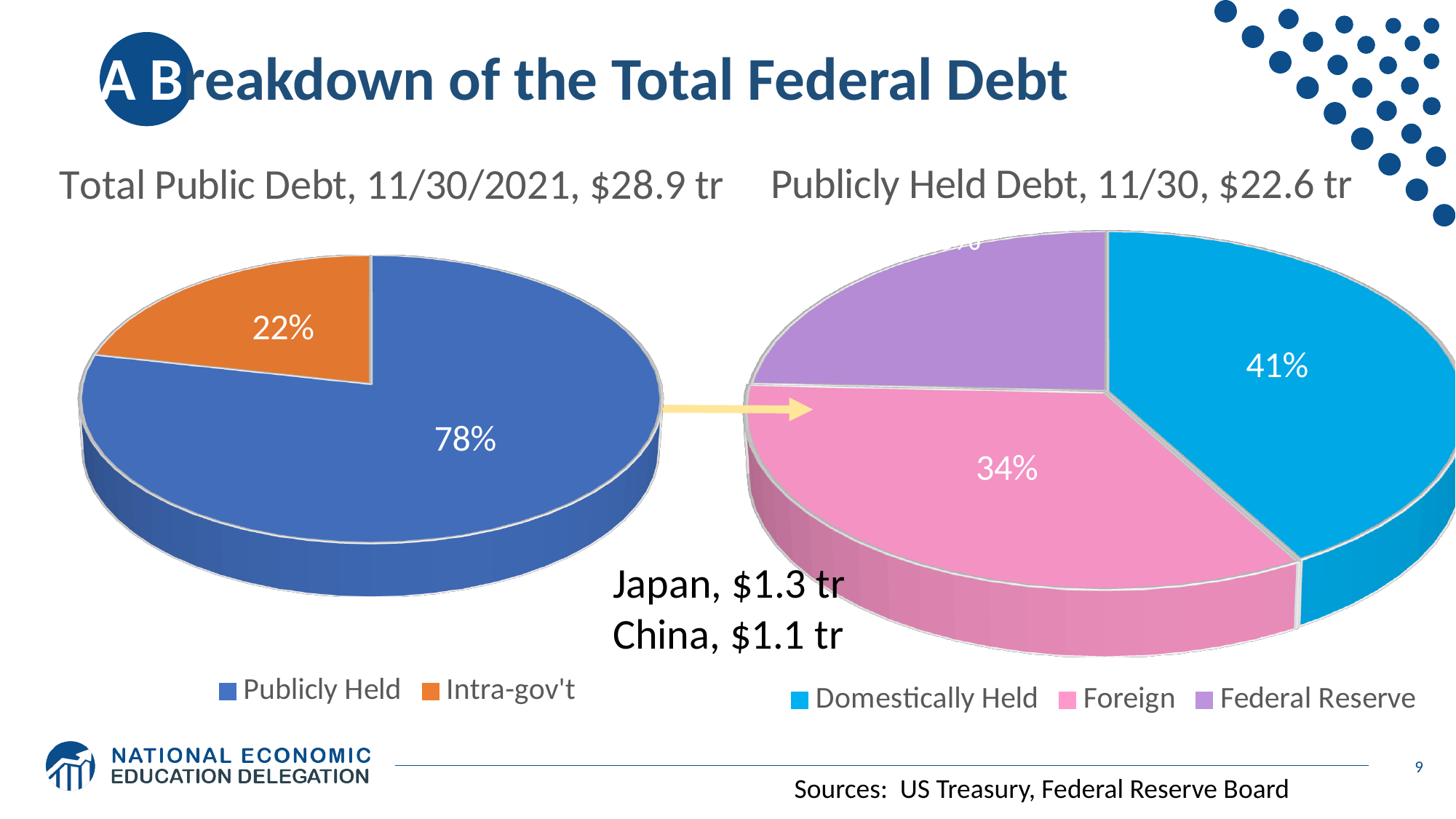
In the Total Public Debt pie chart, what is the difference in percentage points between Publicly Held and Intra-gov't? 56 percentage points In the Publicly Held Debt pie chart, which category has the largest slice? Domestically Held What total amount is given in the title of the Publicly Held Debt chart on the right? $22.6 tr In the Publicly Held Debt pie chart, which category has the smallest slice? Federal Reserve In the Publicly Held Debt pie chart, what share is Foreign? 34% What type of chart is used for the Total Public Debt on the left? Pie chart In the Total Public Debt pie chart, what share is Intra-gov't? 22% In the Total Public Debt pie chart, which category has the larger slice, Publicly Held or Intra-gov't? Publicly Held In the Total Public Debt pie chart, what share is Publicly Held? 78% How many categories does the legend of the Publicly Held Debt pie chart list? 3 In the Publicly Held Debt pie chart, what share is Domestically Held? 41% In the Publicly Held Debt pie chart, what is the difference in percentage points between Domestically Held and Foreign? 7 percentage points